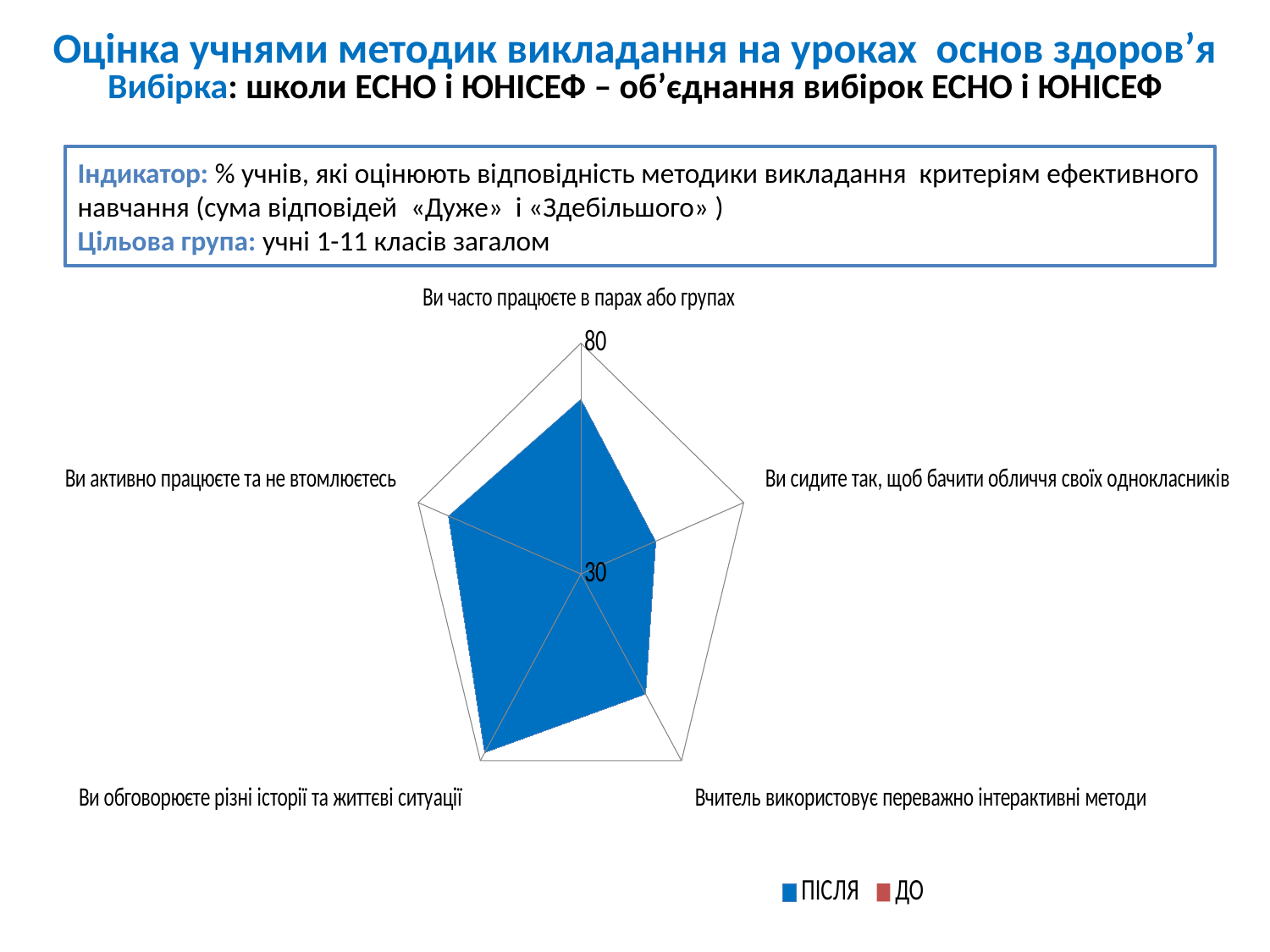
Which category has the lowest value for ПІСЛЯ? Ви сидите так, щоб бачити обличчя своїх однокласників Is the ПІСЛЯ value for 'Ви сидите так, щоб бачити обличчя своїх однокласників' greater or less than 30? greater For ПІСЛЯ, which is larger: 'Ви часто працюєте в парах або групах' or 'Ви сидите так, щоб бачити обличчя своїх однокласників'? Ви часто працюєте в парах або групах How many series does the legend list? 2 Is the ПІСЛЯ value for 'Ви часто працюєте в парах або групах' greater or less than 80? less For ПІСЛЯ, which is larger: 'Ви обговорюєте різні історії та життєві ситуації' or 'Ви сидите так, щоб бачити обличчя своїх однокласників'? Ви обговорюєте різні історії та життєві ситуації What kind of chart is shown on the slide? radar chart What are the two series named in the legend? ПІСЛЯ and ДО How many categories (axes) does the radar chart have? 5 Which category has the highest value for ПІСЛЯ? Ви обговорюєте різні історії та життєві ситуації What colour is used for the ПІСЛЯ series? blue